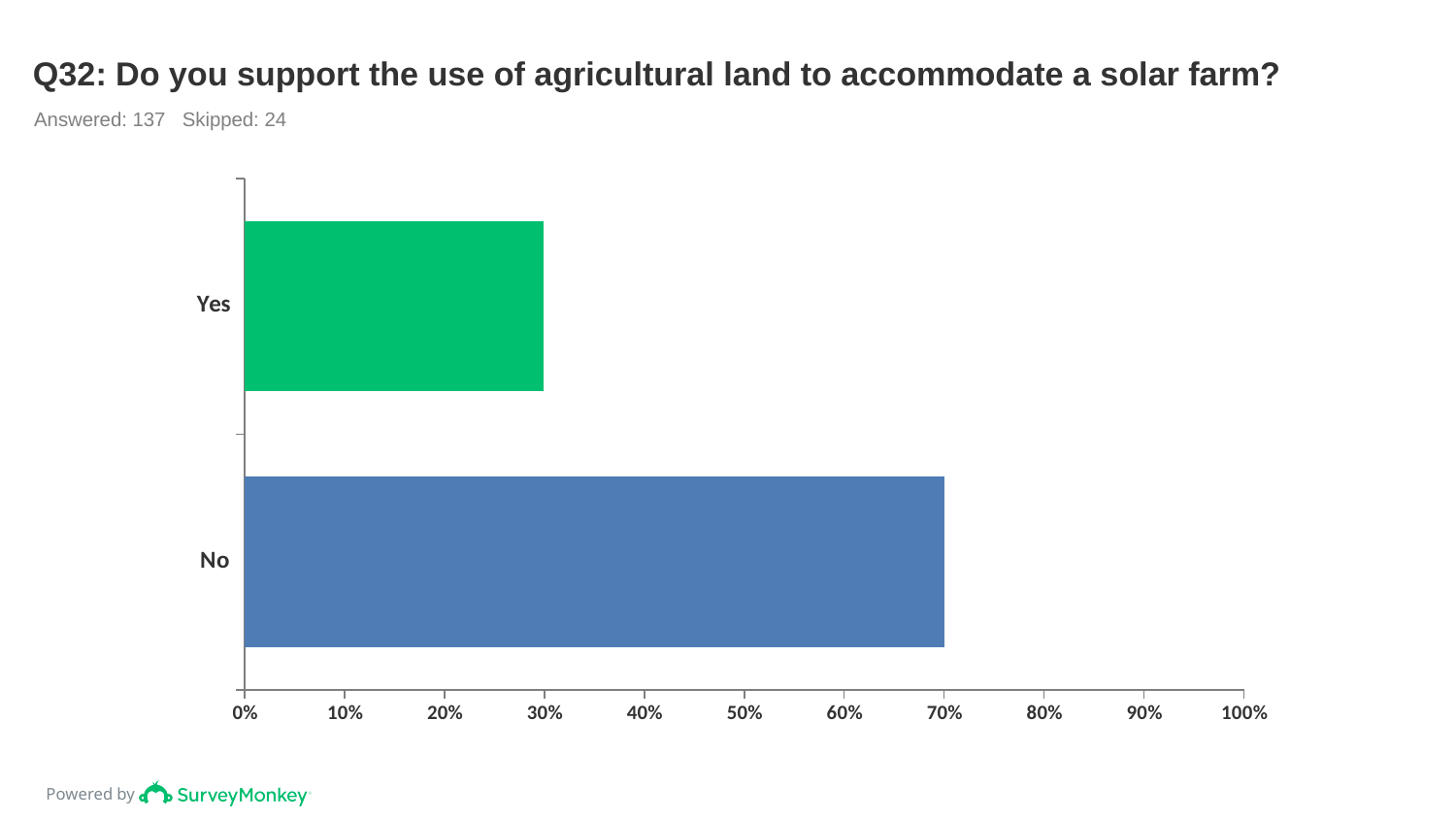
What is the title of the chart? Q32: Do you support the use of agricultural land to accommodate a solar farm? What type of chart is shown on the slide? bar chart Is the value for Yes greater or less than 20%? greater Is the value for Yes greater or less than 40%? less Which is larger, the value for Yes or the value for No? No Which category has the highest value? No What is the maximum value shown on the x axis? 100% Is the value for No greater or less than 60%? greater How many categories are plotted in the chart? 2 How many respondents answered the question according to the slide? 137 Which category has the lowest value? Yes